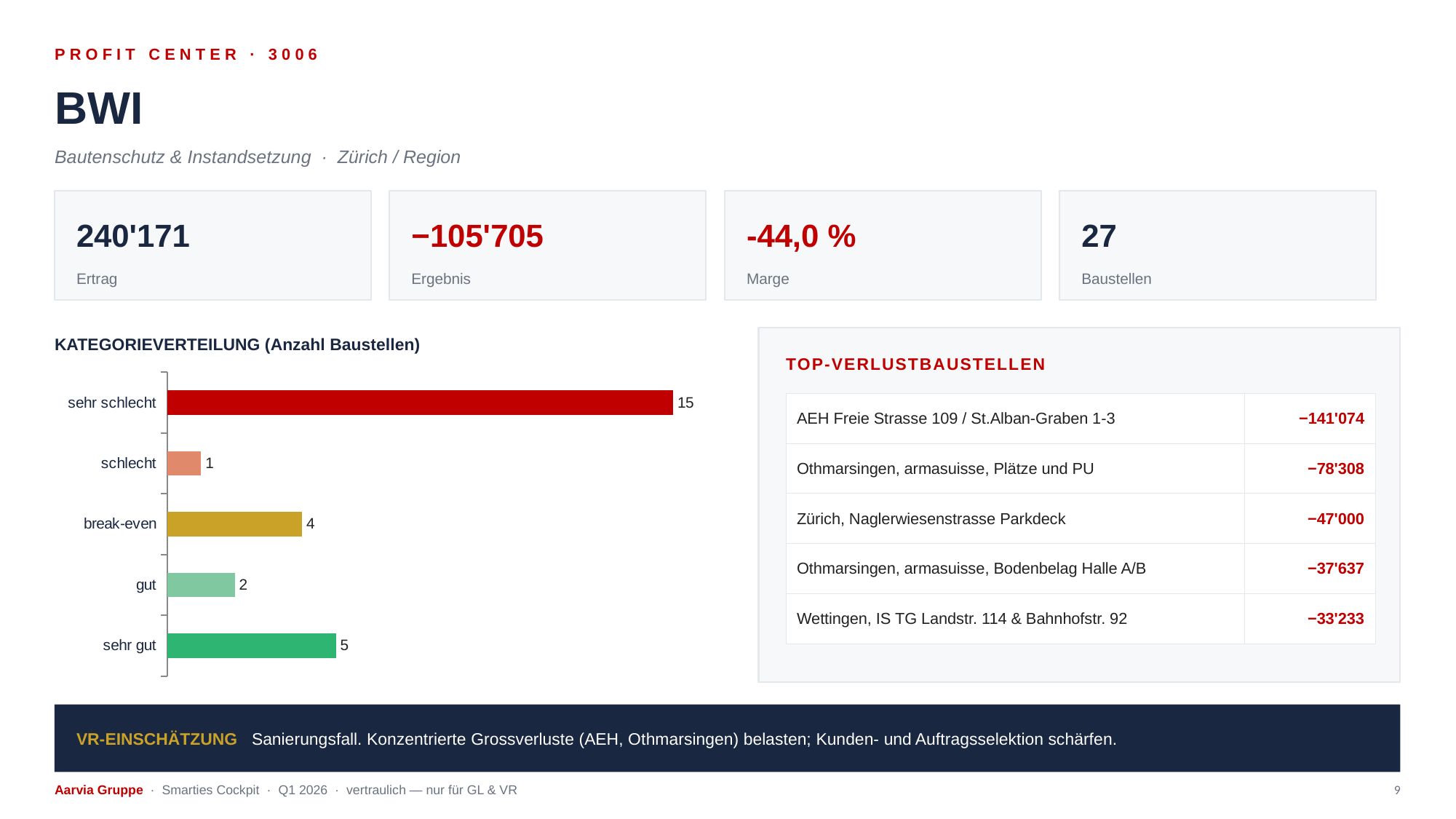
What is the difference between the values for 'sehr schlecht' and 'sehr gut' in the KATEGORIEVERTEILUNG chart? 10 What is the total of all category values in the KATEGORIEVERTEILUNG chart? 27 Which category has the highest value in the KATEGORIEVERTEILUNG chart? sehr schlecht How many categories does the KATEGORIEVERTEILUNG chart show? 5 What colour is the bar for 'sehr schlecht' in the KATEGORIEVERTEILUNG chart? red In the KATEGORIEVERTEILUNG chart, which is larger: the value for 'break-even' or the value for 'gut'? break-even What is the value for 'break-even' in the KATEGORIEVERTEILUNG chart? 4 What kind of chart is the KATEGORIEVERTEILUNG chart? bar chart What is the value for 'gut' in the KATEGORIEVERTEILUNG chart? 2 What is the value for 'sehr schlecht' in the KATEGORIEVERTEILUNG chart? 15 What is the value for 'sehr gut' in the KATEGORIEVERTEILUNG chart? 5 Which category has the lowest value in the KATEGORIEVERTEILUNG chart? schlecht